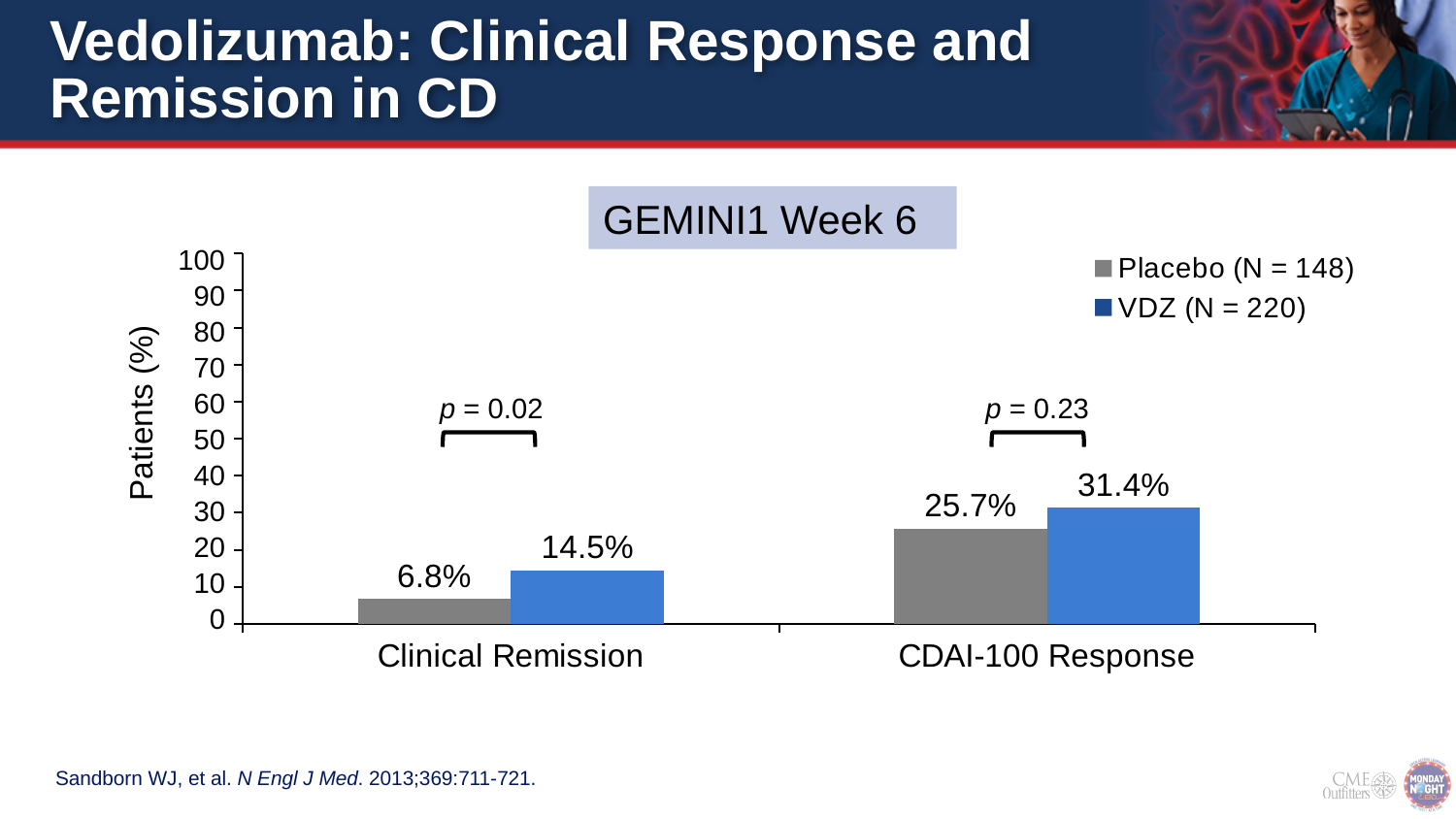
What is the p-value shown above the Clinical Remission bars? p = 0.02 What is the value for Placebo in the Clinical Remission category? 6.8% What kind of chart is shown on the slide? Bar chart What is the value for VDZ in the Clinical Remission category? 14.5% Which bar has the highest value on the chart? VDZ, CDAI-100 Response What is the value for Placebo in the CDAI-100 Response category? 25.7% Which is larger for CDAI-100 Response, Placebo or VDZ? VDZ Which bar has the lowest value on the chart? Placebo, Clinical Remission What is the difference between the VDZ and Placebo values for Clinical Remission? 7.7% What is the difference between the VDZ and Placebo values for CDAI-100 Response? 5.7% How many series does the legend list? 2 What is the value for VDZ in the CDAI-100 Response category? 31.4%